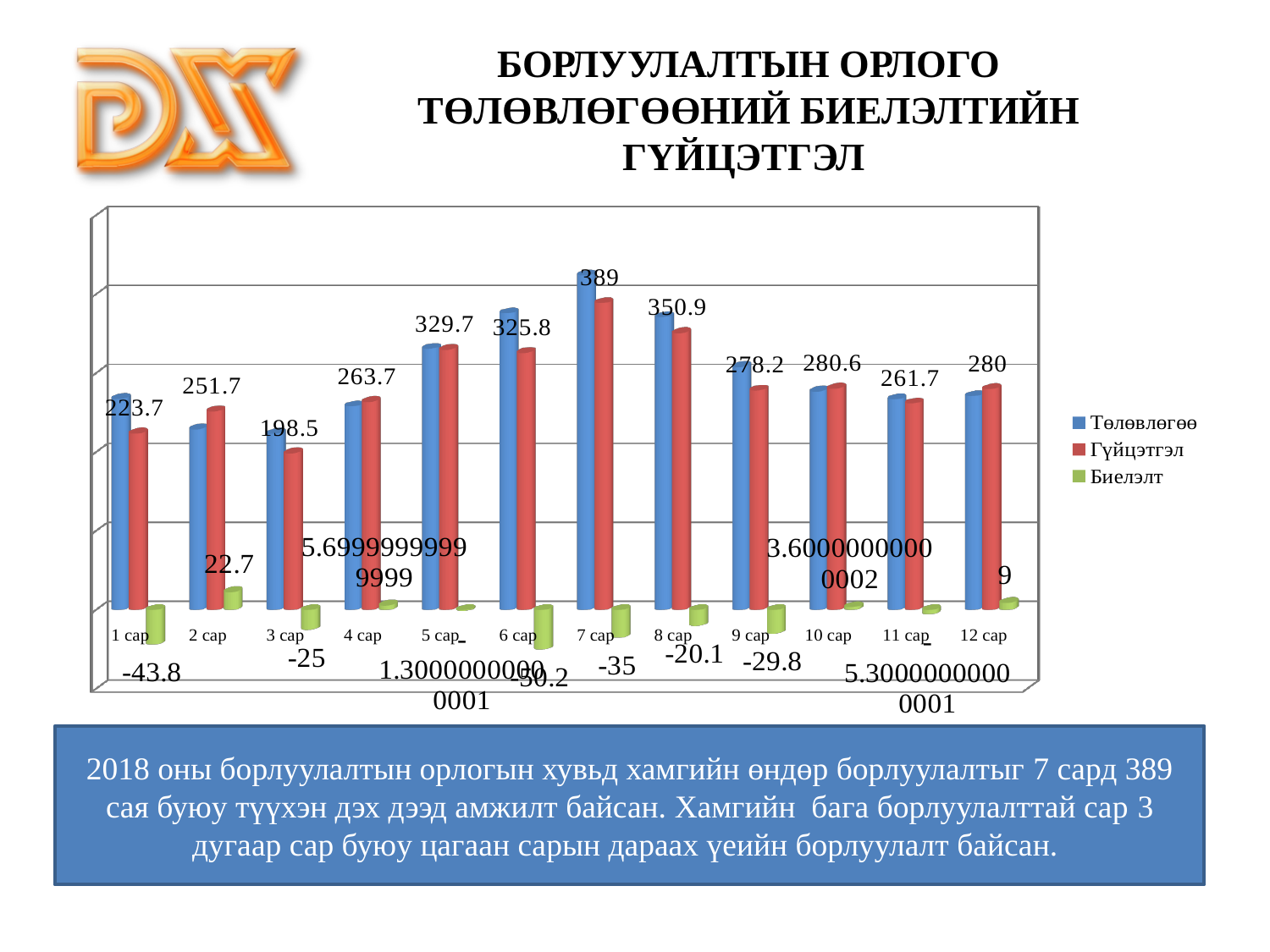
Which month has the highest value among the large data labels above the bars? 7 сар How many months (categories) are shown on the x axis? 12 Which colour represents the Биелэлт series in the legend? green What is the large data label shown above the bars for 7 сар? 389 What is the Биелэлт value labelled for 6 сар? -50.2 Which month has the lowest value among the large data labels above the bars? 3 сар What kind of chart is shown on the slide? bar chart How many series does the legend list? 3 What is the Биелэлт value labelled for 12 сар? 9 What is the Биелэлт value labelled for 1 сар? -43.8 What is the large data label shown above the bars for 8 сар? 350.9 Which month has the lowest Биелэлт value? 6 сар